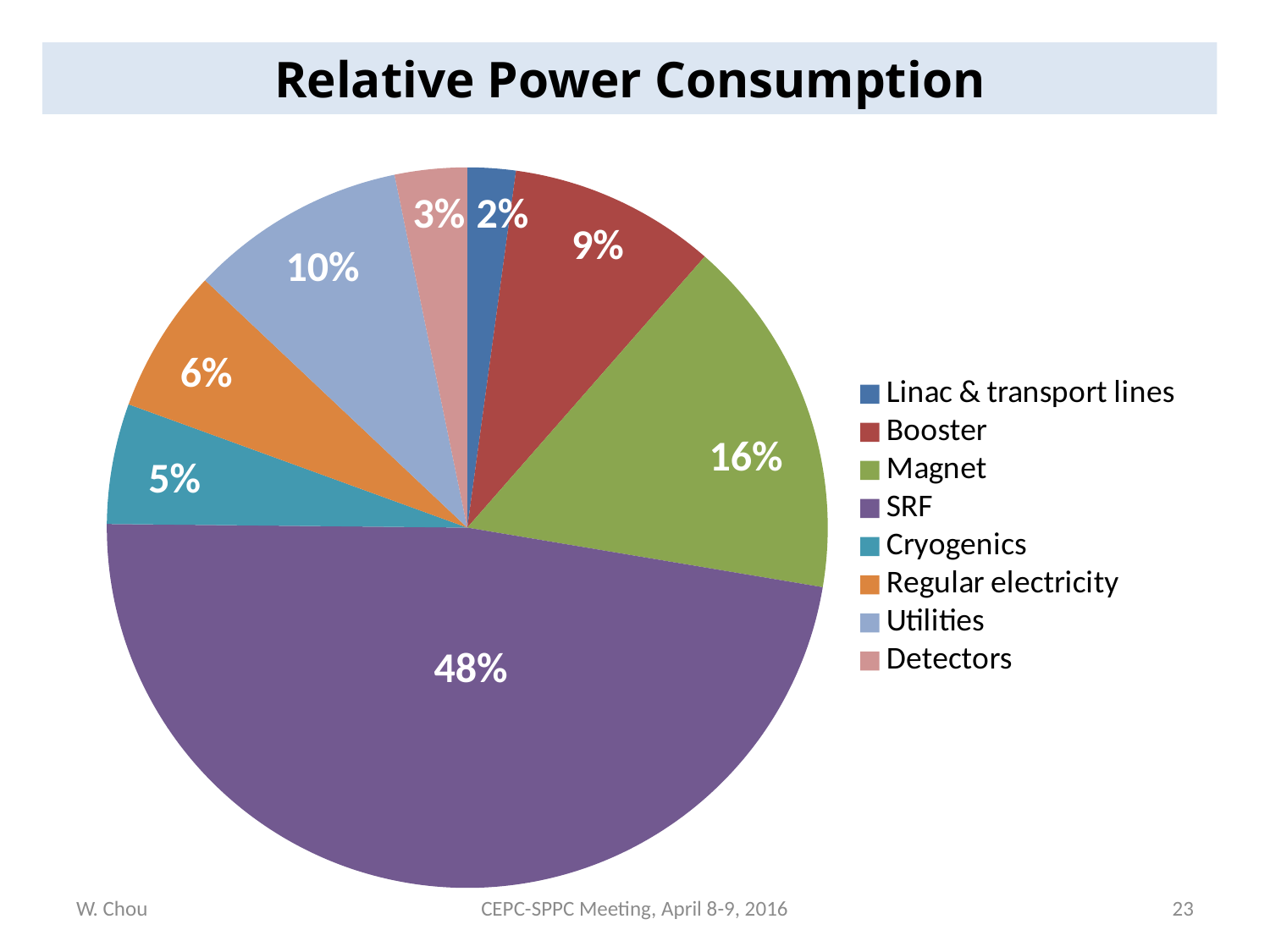
What type of chart is shown on the slide? pie chart What is the difference in percentage points between the SRF share and the Magnet share? 32 Which has a larger share, Cryogenics or Regular electricity? Regular electricity Which category has the smallest share of relative power consumption? Linac & transport lines What share of relative power consumption does SRF account for? 48% What is the title of the chart? Relative Power Consumption What share of relative power consumption does Linac & transport lines account for? 2% How many categories are shown in the pie chart? 8 What share of relative power consumption do Utilities account for? 10% Which category has the largest share of relative power consumption? SRF